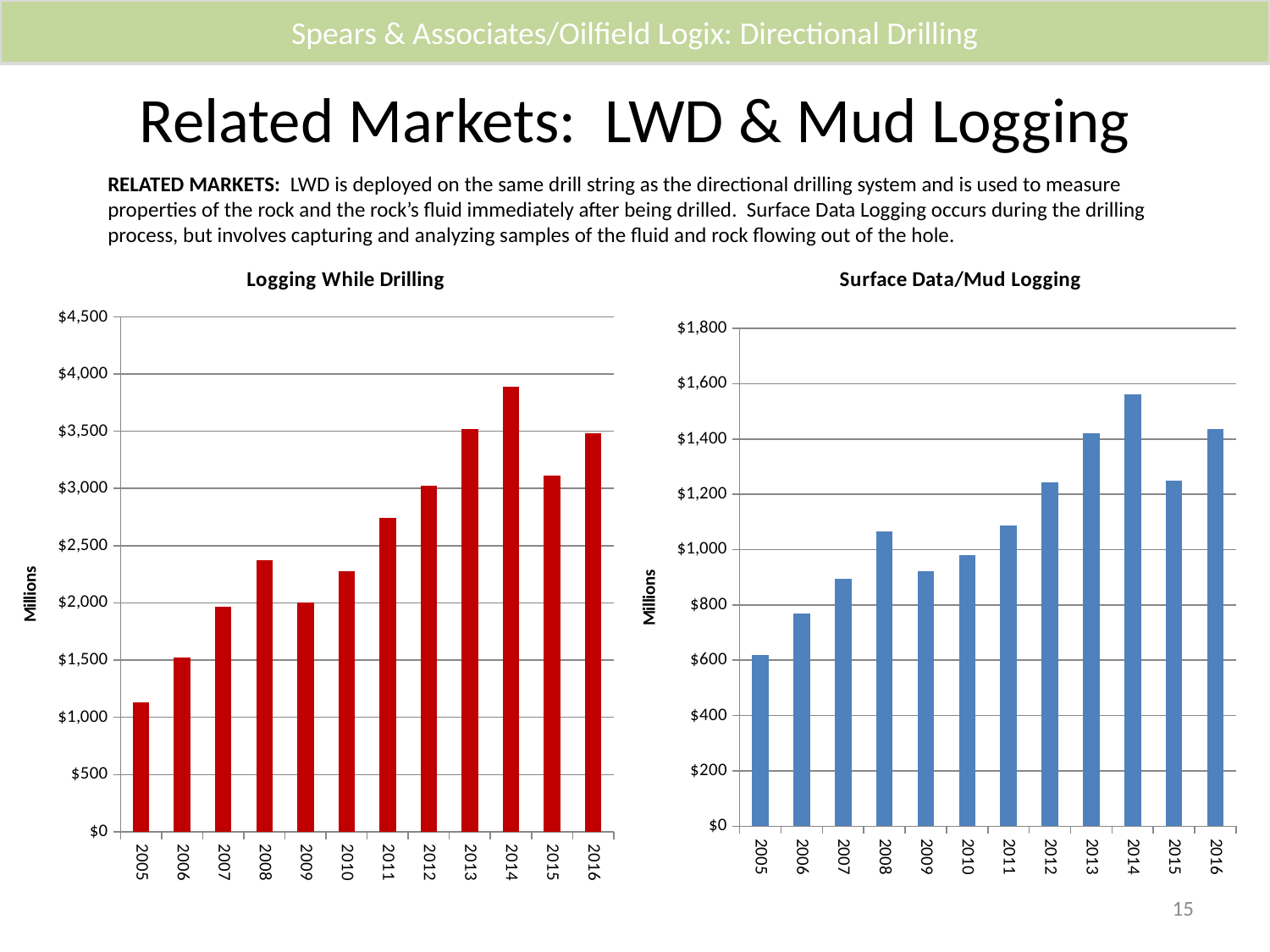
In the Logging While Drilling chart, which year has the highest value? 2014 How many years are shown on the x axis of the Logging While Drilling chart? 12 In the Logging While Drilling chart, which is larger, the value for 2013 or the value for 2015? 2013 In the Surface Data/Mud Logging chart, which year has the highest value? 2014 What kind of chart is the Logging While Drilling chart? Bar chart In the Surface Data/Mud Logging chart, which is larger, the value for 2008 or the value for 2009? 2008 In the Logging While Drilling chart, is the value for 2011 greater or less than $2,500? greater What is the y-axis label on the Surface Data/Mud Logging chart? Millions In the Surface Data/Mud Logging chart, which year has the lowest value? 2005 In the Surface Data/Mud Logging chart, is the value for 2005 greater or less than $800? less In the Logging While Drilling chart, which year has the lowest value? 2005 In the Logging While Drilling chart, is the value for 2014 greater or less than $3,500? greater